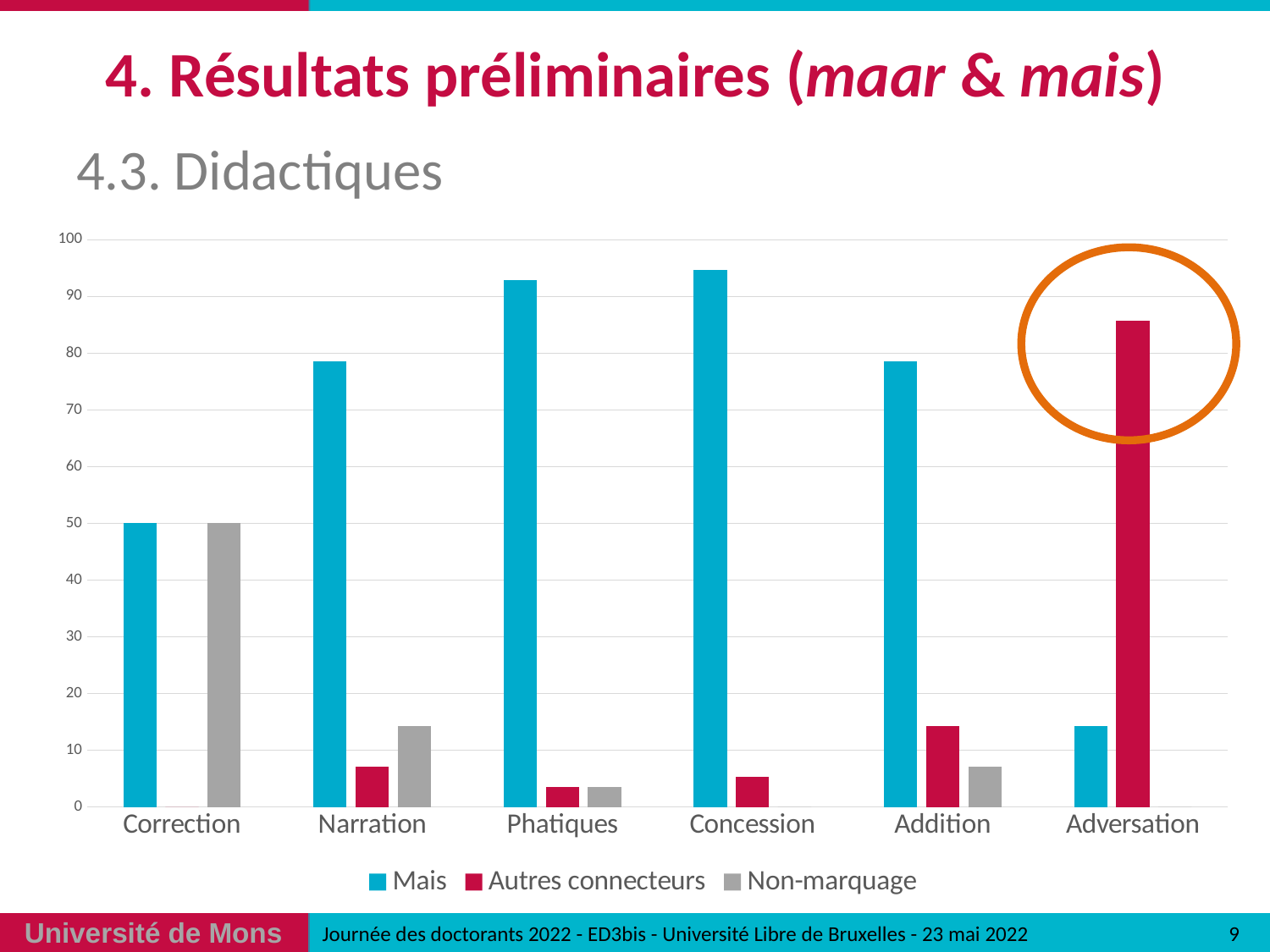
Is the Autres connecteurs value for Adversation greater or less than 80? greater Which category has the highest value for the Autres connecteurs series? Adversation For Adversation, which series has the larger value: Mais or Autres connecteurs? Autres connecteurs Is the Mais value for Phatiques greater or less than 90? greater Is the Autres connecteurs value for Addition greater or less than 10? greater Which category has the lowest value for the Mais series? Adversation Which category's bar is highlighted with an orange circle? Adversation Which is larger: the Mais value for Narration or the Mais value for Adversation? Narration What kind of chart is shown on the slide? bar chart How many categories are shown on the x axis? 6 How many series does the legend list? 3